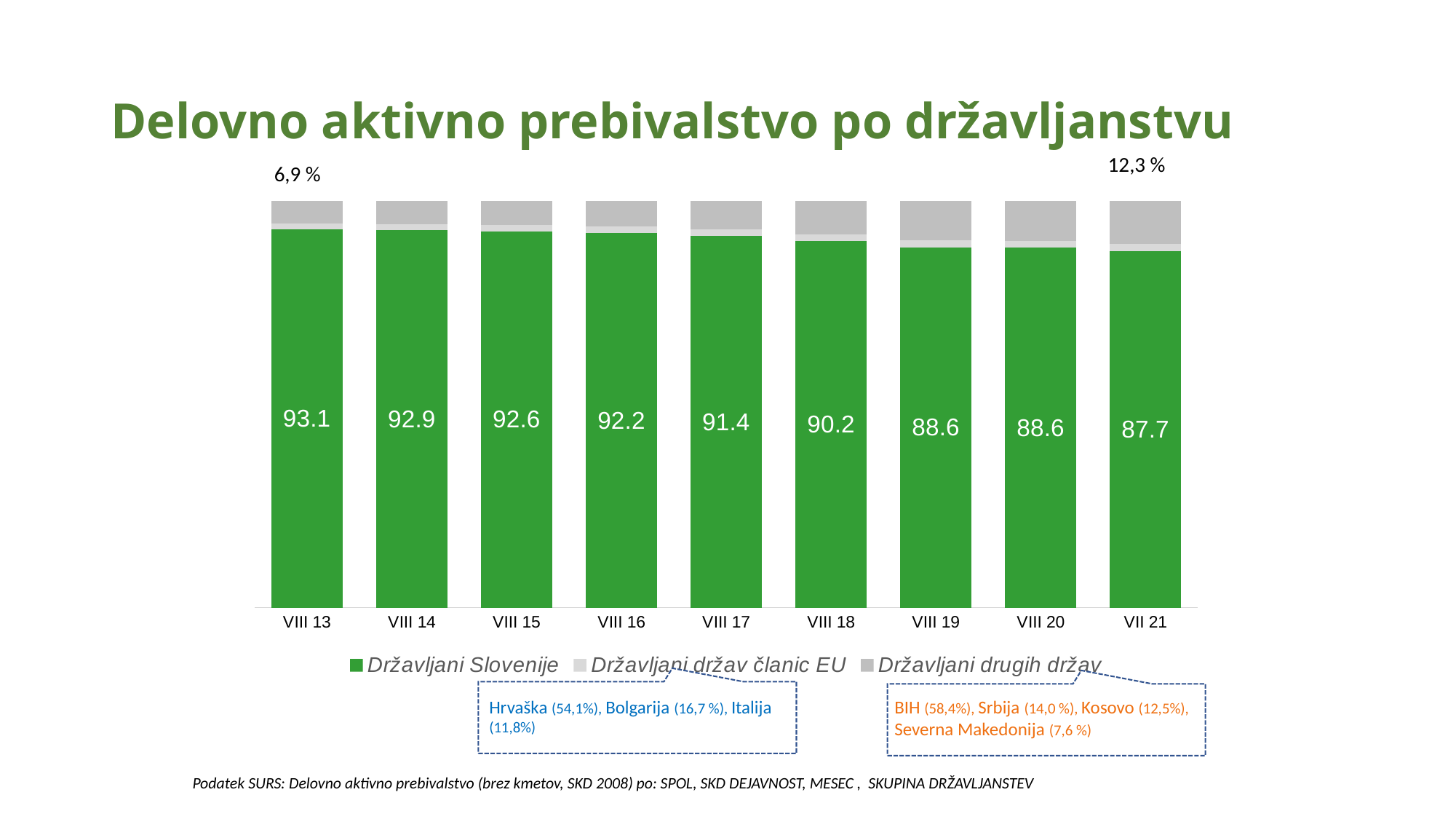
How many series does the legend list? 3 What is the difference between the Državljani Slovenije values for VIII 13 and VII 21? 5.4 How many periods are shown on the x axis? 9 What kind of chart is shown on the slide? Stacked bar chart What is the difference between the Državljani Slovenije values for VIII 14 and VIII 18? 2.7 What is the value for Državljani Slovenije in VIII 13? 93.1 In which period is the value for Državljani Slovenije the lowest? VII 21 What is the value for Državljani Slovenije in VIII 17? 91.4 In which period is the value for Državljani Slovenije the highest? VIII 13 What is the value for Državljani Slovenije in VII 21? 87.7 Does the value for Državljani Slovenije rise or fall from VIII 13 to VII 21? Fall Which has a larger Državljani Slovenije value, VIII 16 or VIII 18? VIII 16